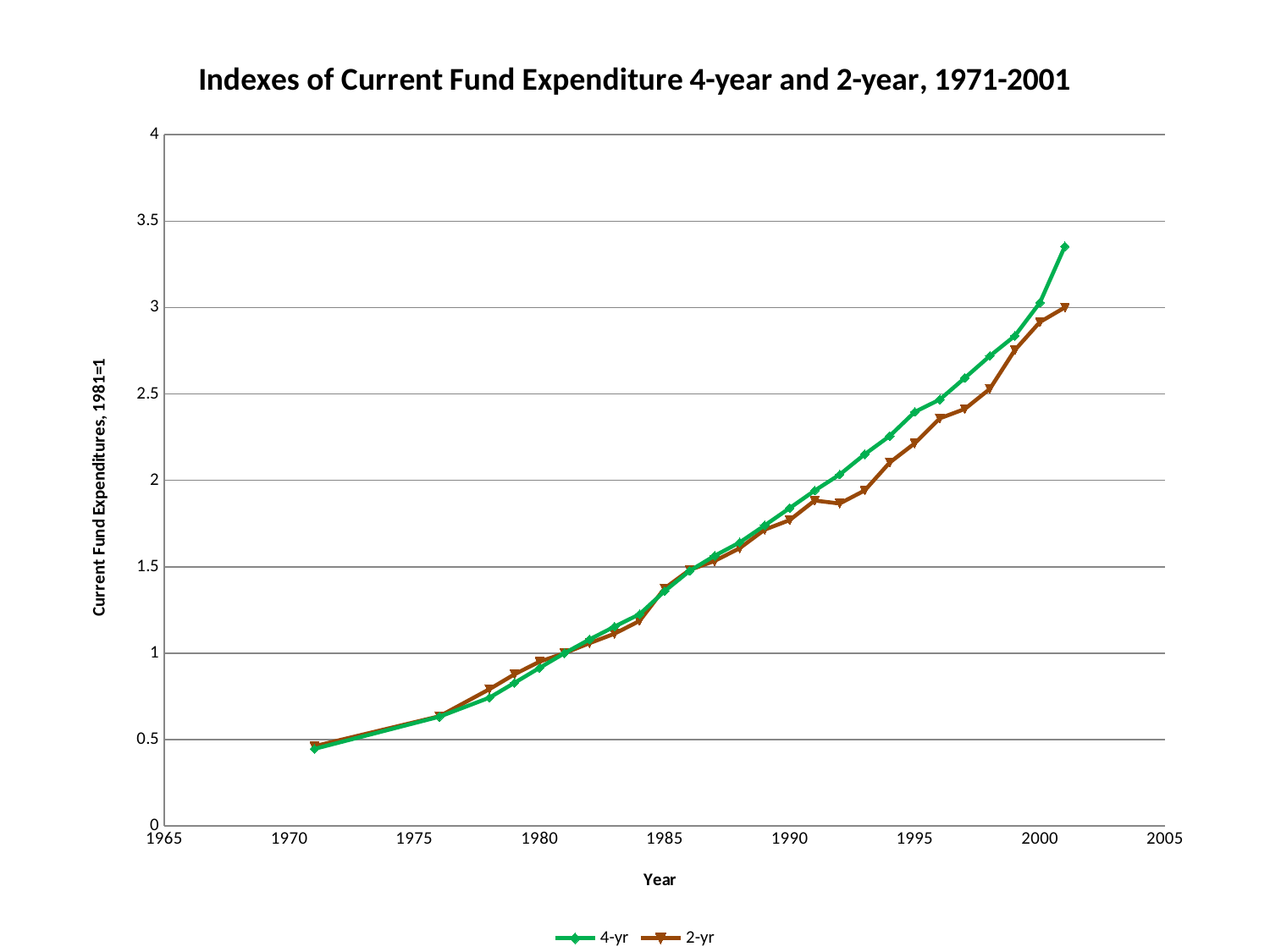
Do the 4-yr values rise or fall from 1971 to 2001? rise Is the value for the 2-yr series in 1990 greater or less than 2? less What are the two series named in the legend? 4-yr and 2-yr How many series does the legend list? 2 What kind of chart is shown on the slide? line chart In which year does the 4-yr series reach its highest value? 2001 In 2001, which series has the higher value, 4-yr or 2-yr? 4-yr What is the value of the 4-yr series in 1981? 1 Is the value for the 4-yr series in 2001 greater or less than 3.5? less Is the value for the 4-yr series in 2001 greater or less than 3? greater What is the title of the chart? Indexes of Current Fund Expenditure 4-year and 2-year, 1971-2001